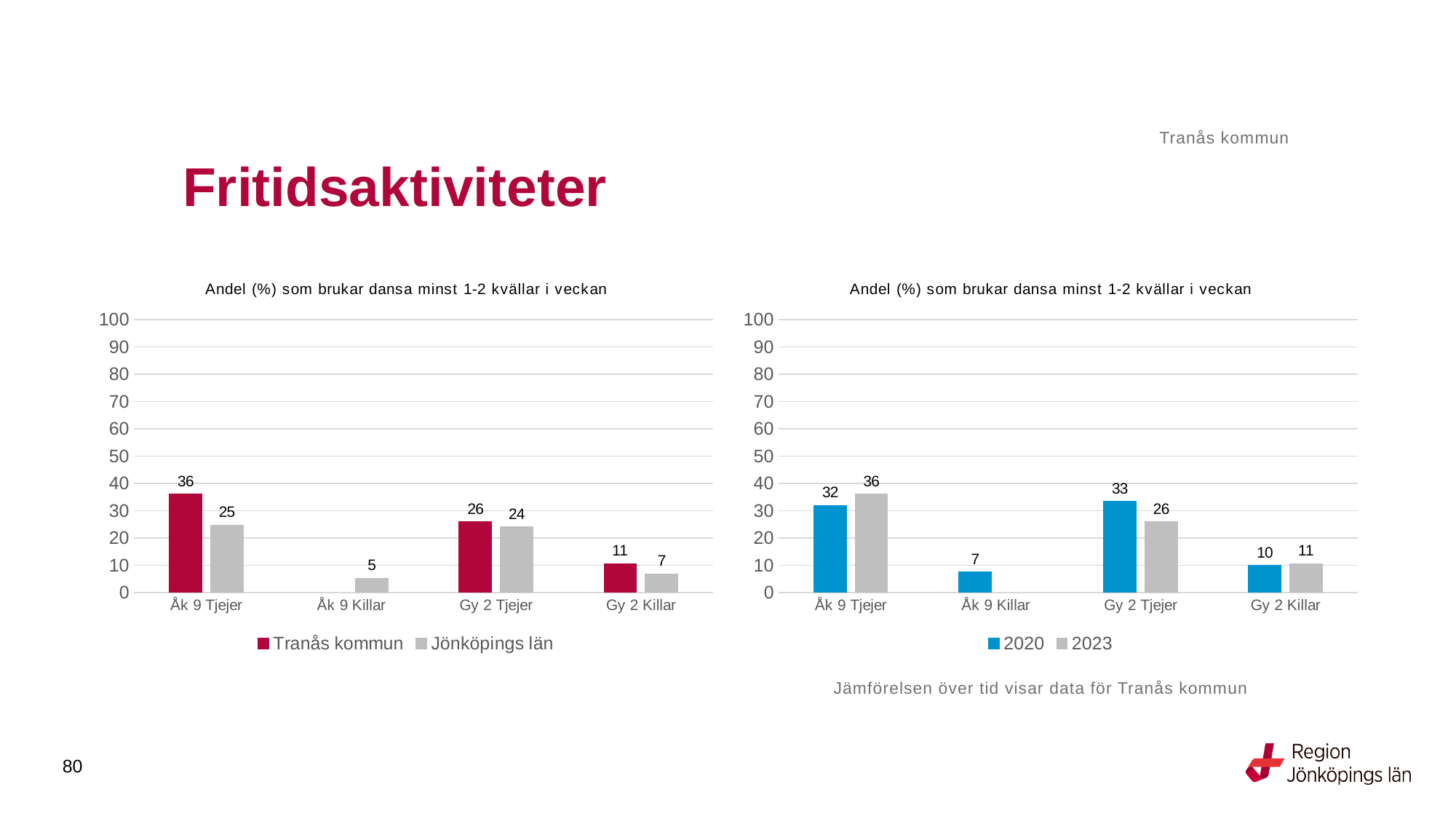
In the left chart, how many series does the legend list? 2 In the left chart, what is the value for Tranås kommun for Åk 9 Tjejer? 36 In the right chart, what is the 2023 value for Åk 9 Tjejer? 36 In the left chart, which category has the lowest Jönköpings län value? Åk 9 Killar In the left chart, what is the difference between Tranås kommun and Jönköpings län for Åk 9 Tjejer? 11 In the right chart, how many categories are shown on the x axis? 4 In the left chart, which category has the highest Jönköpings län value? Åk 9 Tjejer What type of chart is the right chart? Bar chart In the right chart, what is the 2020 value for Gy 2 Tjejer? 33 In the left chart, what is the value for Jönköpings län for Åk 9 Killar? 5 In the right chart, which is larger for Gy 2 Tjejer, the 2020 value or the 2023 value? 2020 In the right chart, what is the difference between the 2023 and 2020 values for Åk 9 Tjejer? 4